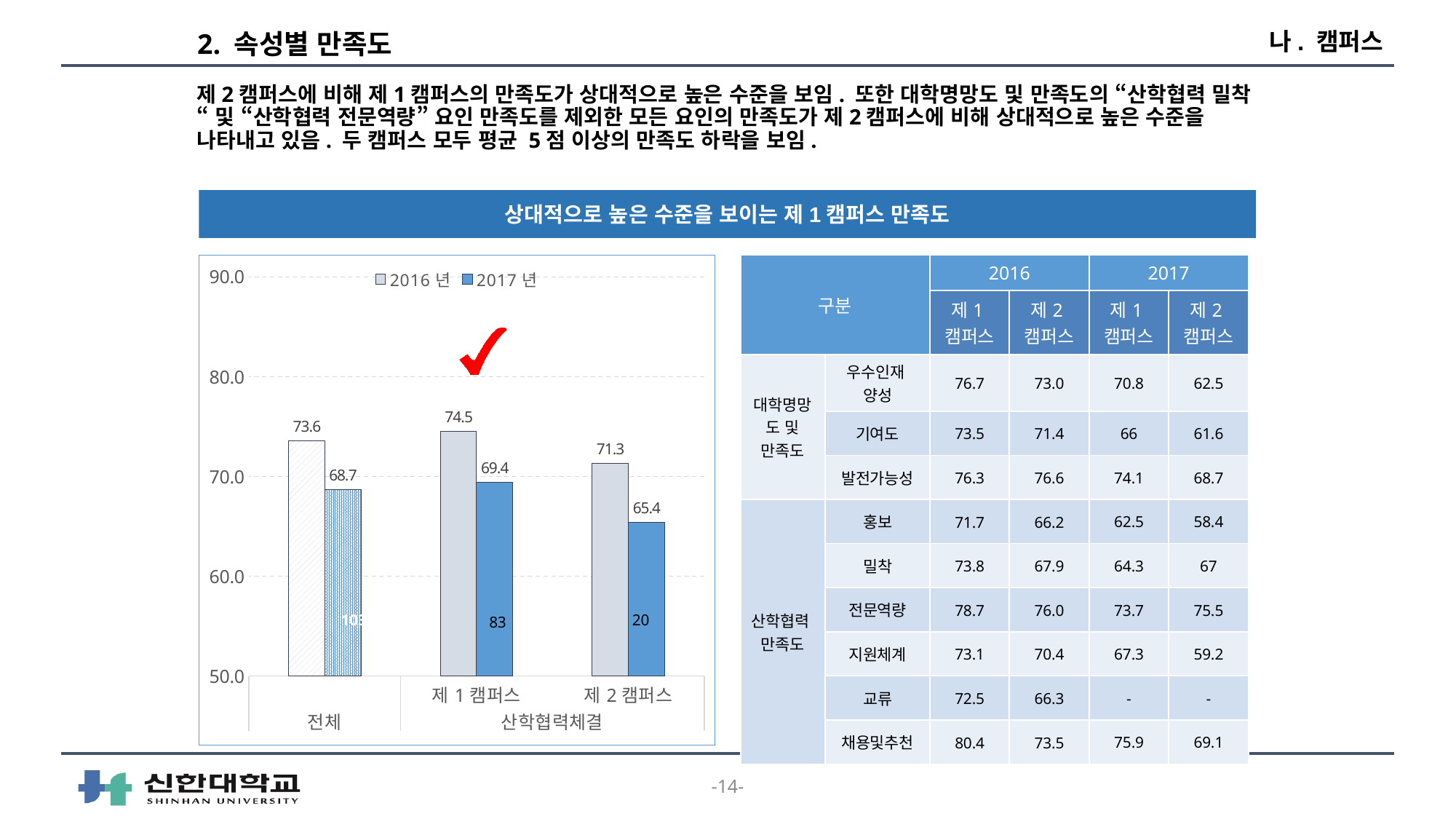
How many categories are shown on the x axis of the chart? 3 How many series does the legend list? 2 What is the 2017 년 value for 제 2 캠퍼스? 65.4 What is the 2016 년 value for 제 1 캠퍼스? 74.5 What is the difference between the 2016 년 values for 제 1 캠퍼스 and 제 2 캠퍼스? 3.2 Which category has the highest 2016 년 value? 제 1 캠퍼스 What is the 2017 년 value for 전체? 68.7 What is the 2016 년 value for 전체? 73.6 What kind of chart is shown on the slide? Bar chart What is the difference between the 2016 년 and 2017 년 values for 제 1 캠퍼스? 5.1 Which is larger, the 2017 년 value for 제 1 캠퍼스 or the 2017 년 value for 제 2 캠퍼스? 제 1 캠퍼스 Which category has the lowest 2017 년 value? 제 2 캠퍼스